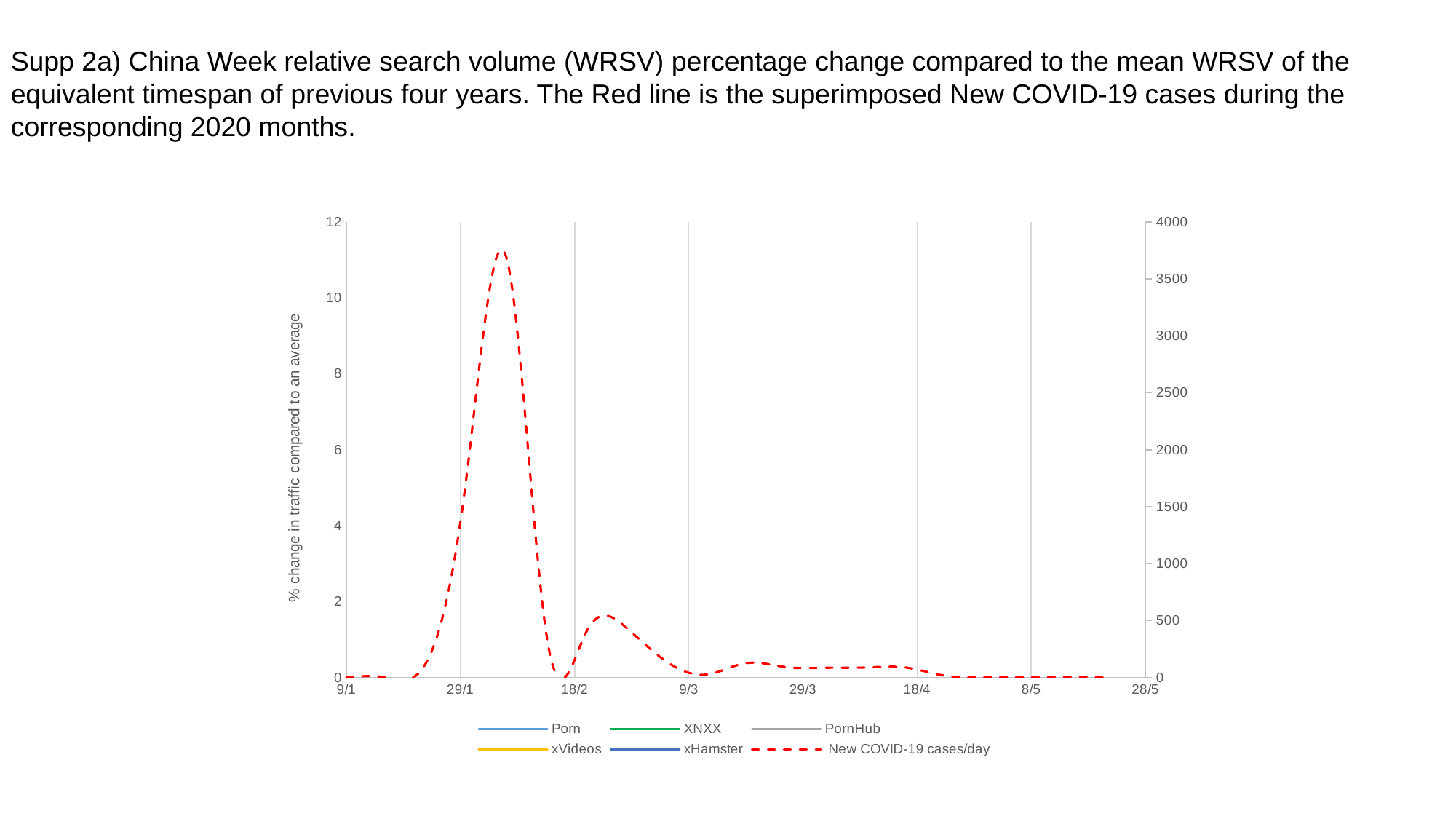
Is the peak of the New COVID-19 cases/day line greater or less than 3500 on the right axis? greater What is the last date label on the x axis? 28/5 What is the highest value shown on the left-hand vertical axis? 12 Does the New COVID-19 cases/day line rise or fall between 9/1 and 29/1? rise What is the highest value shown on the right-hand vertical axis? 4000 How many series does the chart's legend list? 6 How many date labels are shown along the x axis? 8 What is the first date label on the x axis? 9/1 What is the label of the left vertical axis? % change in traffic compared to an average What kind of chart is shown on the slide? line chart Which series is drawn as a red dashed line? New COVID-19 cases/day Is the value of the New COVID-19 cases/day line at 9/3 greater or less than 500 on the right axis? less